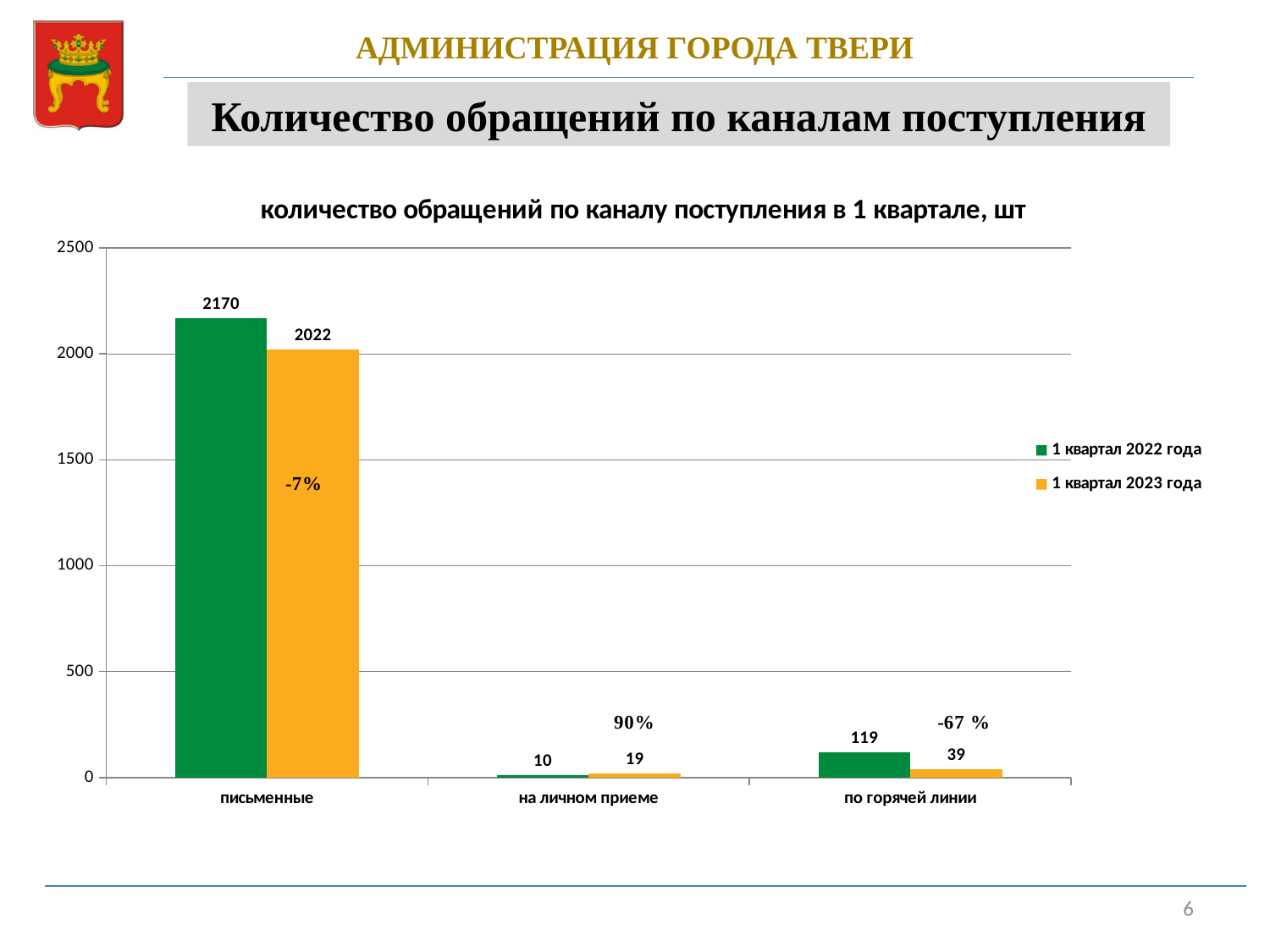
How many series does the legend list? 2 What is the value for по горячей линии in 1 квартал 2022 года? 119 How many categories are shown on the x axis? 3 What is the value for письменные in 1 квартал 2022 года? 2170 What is the difference between the 1 квартал 2022 года and 1 квартал 2023 года values for письменные? 148 What is the value for на личном приеме in 1 квартал 2023 года? 19 What is the value for письменные in 1 квартал 2023 года? 2022 Which is larger for на личном приеме: the 1 квартал 2022 года value or the 1 квартал 2023 года value? 1 квартал 2023 года Which category has the lowest value in 1 квартал 2023 года? на личном приеме What is the difference between the 1 квартал 2022 года and 1 квартал 2023 года values for по горячей линии? 80 What kind of chart is shown on the slide? bar chart Which category has the highest value in 1 квартал 2022 года? письменные